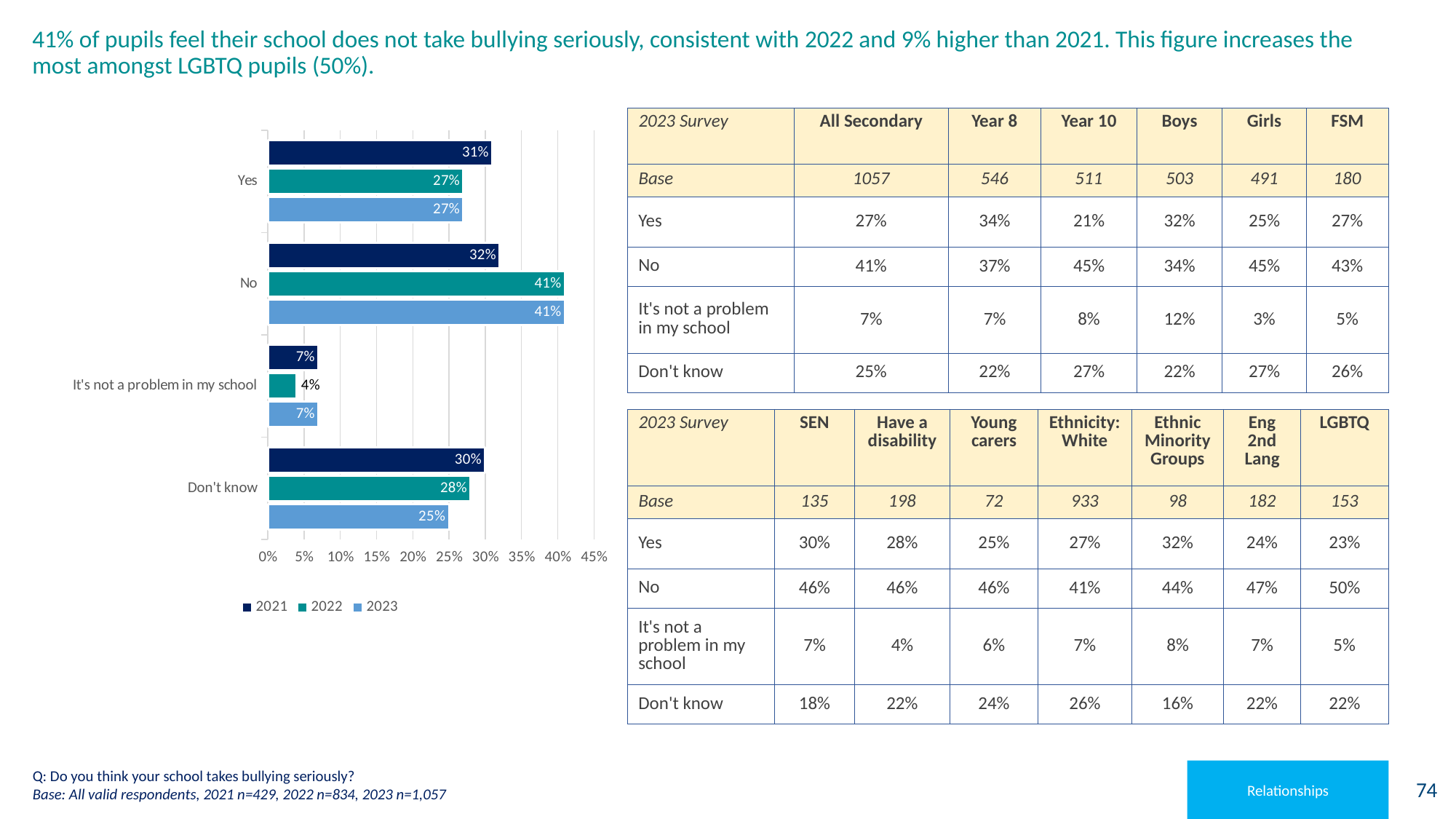
What is the value for 'It's not a problem in my school' in 2022? 4% Which category has the lowest value in the 2021 series? It's not a problem in my school What is the value for 'No' in 2023? 41% What is the difference between the 'No' value in 2022 and the 'No' value in 2021? 9% What is the value for 'Yes' in 2021? 31% What is the value for 'Don't know' in 2023? 25% Which is larger: the 'Yes' value in 2021 or the 'Yes' value in 2023? 2021 How many series does the legend list? 3 What kind of chart is shown on the slide? Bar chart How many response categories are shown on the chart? 4 Which category has the highest value in the 2023 series? No What is the highest value shown on the chart's x axis? 45%